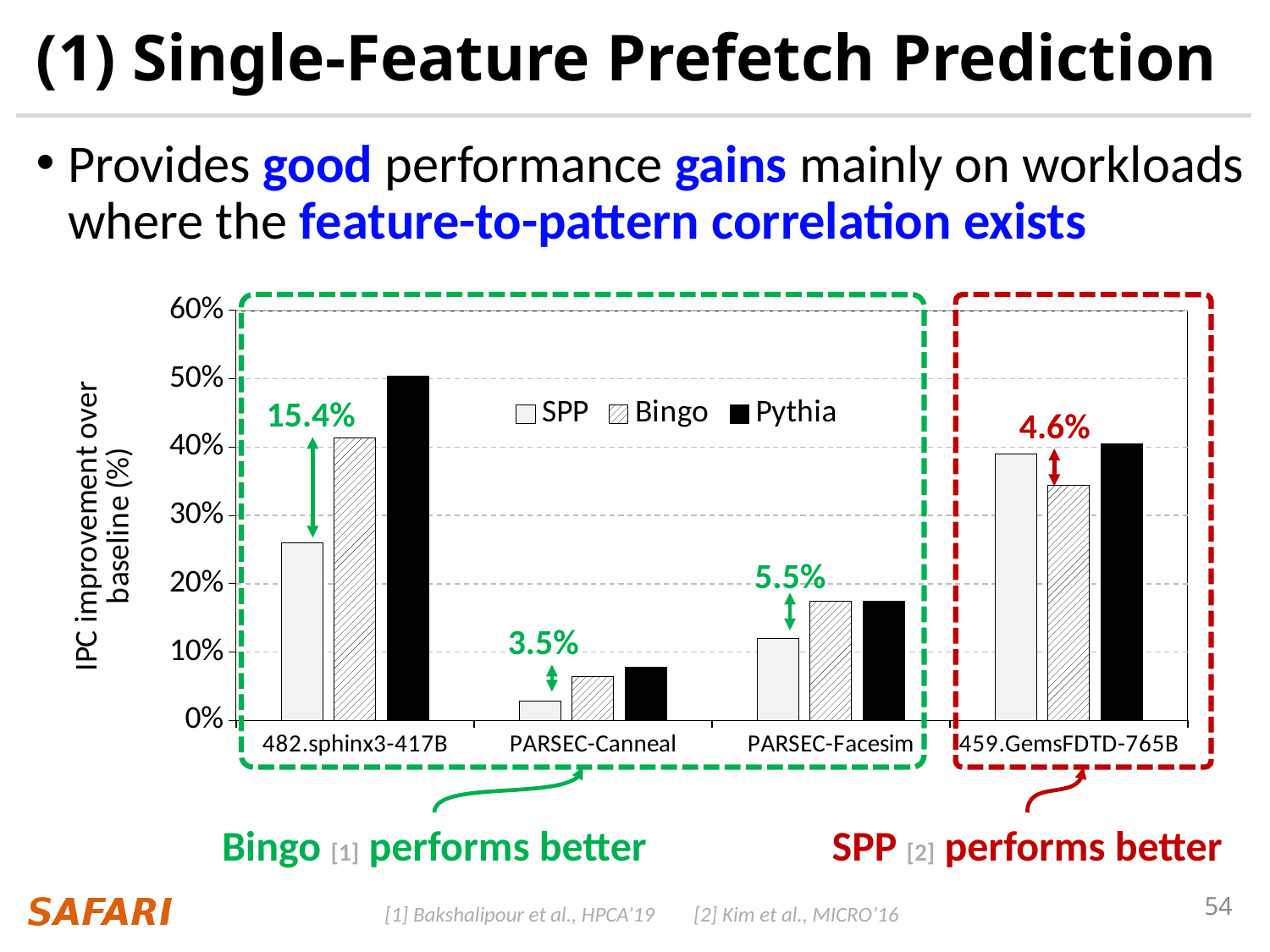
For 482.sphinx3-417B, which is larger, the SPP bar or the Bingo bar? Bingo For which workload is the Pythia bar the highest? 482.sphinx3-417B For which workload is the SPP bar the lowest? PARSEC-Canneal Is the SPP value for PARSEC-Canneal greater or less than 10%? less How many workload categories are shown on the x axis of the chart? 4 According to the annotation on the chart, what is the difference between the Bingo and SPP values for 482.sphinx3-417B? 15.4% What kind of chart is shown on the slide? bar chart For 459.GemsFDTD-765B, which is larger, the SPP bar or the Bingo bar? SPP What is the label of the chart's y axis? IPC improvement over baseline (%) What are the three series named in the chart's legend? SPP, Bingo, Pythia Is the Pythia value for 482.sphinx3-417B greater or less than 40%? greater How many series does the chart's legend list? 3